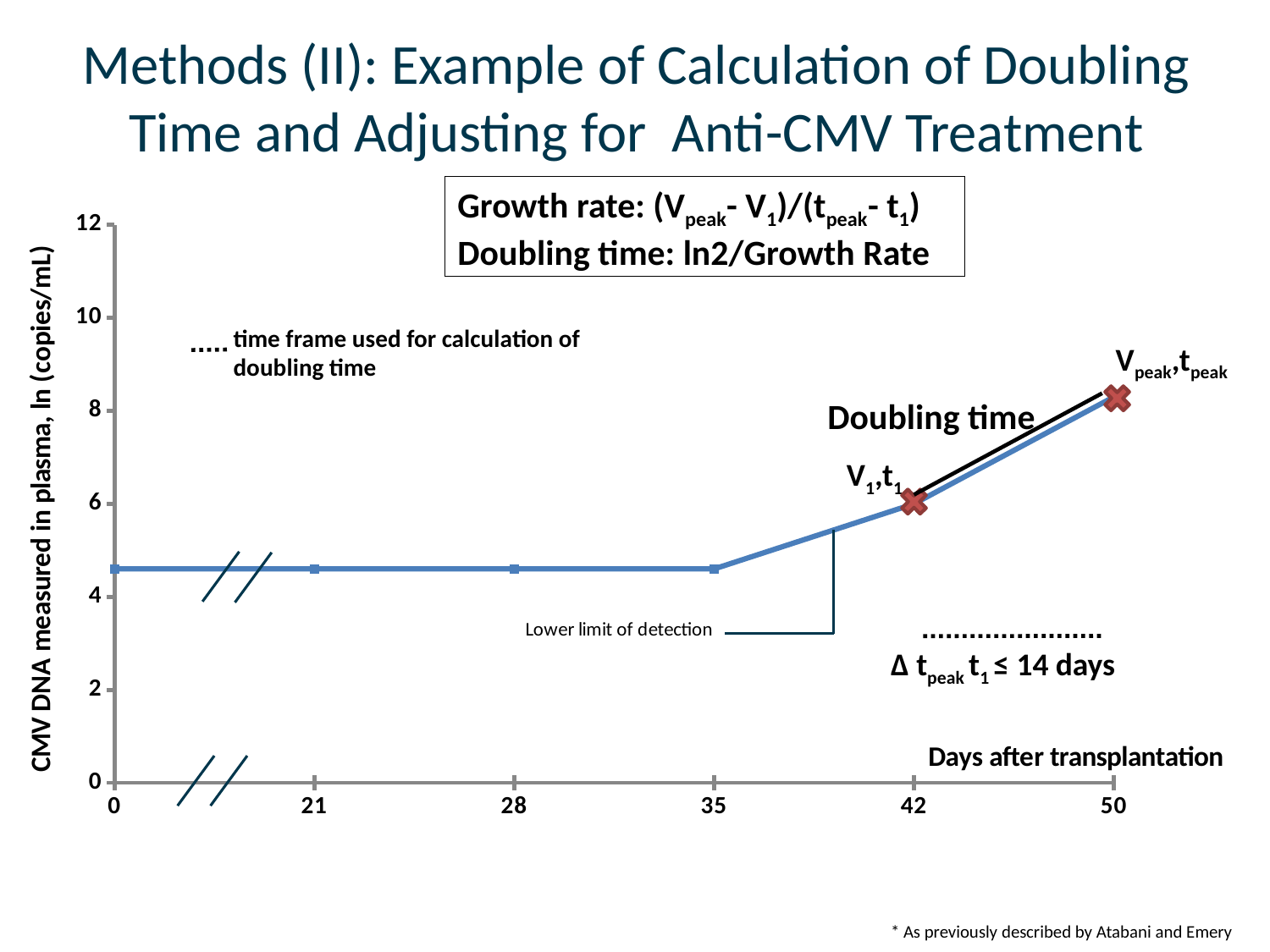
What kind of chart is shown on the slide? line chart Is the plotted value at day 50 greater or less than 10? less What is the title of the y axis of the chart? CMV DNA measured in plasma, ln (copies/mL) Is the plotted value at day 50 greater or less than 6? greater Which has the larger plotted value, day 28 or day 42? day 42 Is the plotted value at day 42 greater or less than 4? greater How many tick labels are shown on the x axis of the chart? 6 At which day after transplantation is the plotted CMV DNA value highest? 50 Which has the larger plotted value, day 42 or day 50? day 50 Do the plotted values rise or fall between day 35 and day 50? rise What does the annotation pointing to the flat part of the line call that level? Lower limit of detection